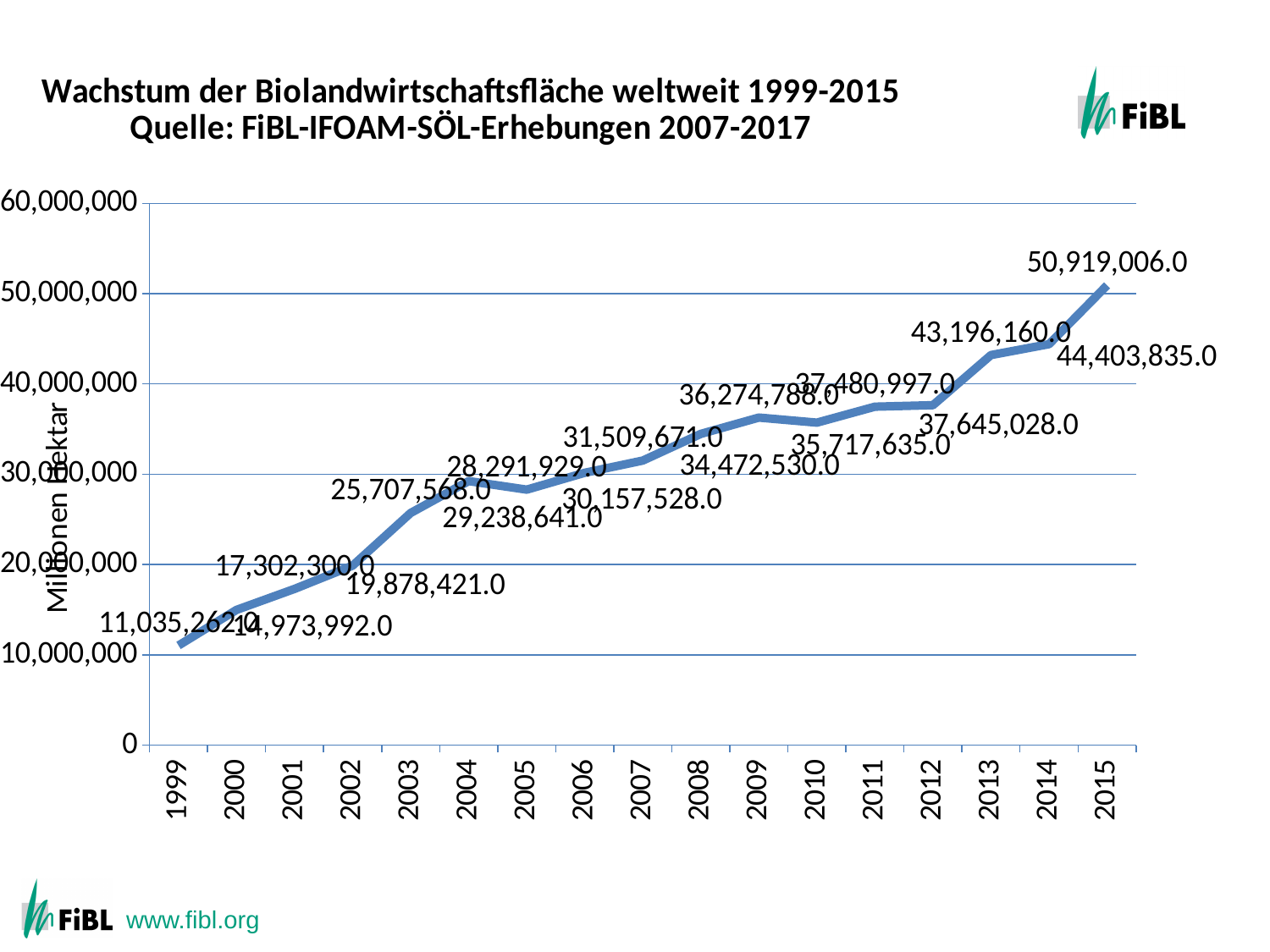
What is the value for 2015? 50,919,006.0 What is the difference between the values for 2015 and 2014? 6,515,171.0 What is the value for 2003? 25,707,568.0 Which is larger, the value for 2004 or the value for 2005? 2004 Is the value for 2010 greater or less than 40,000,000? less How many years (data points) are plotted along the x axis? 17 What is the label on the y axis? Millionen Hektar Which year has the highest value? 2015 What is the value for 2013? 43,196,160.0 What type of chart is shown on the slide? line chart Which year has the lowest value? 1999 What is the value for 2002? 19,878,421.0